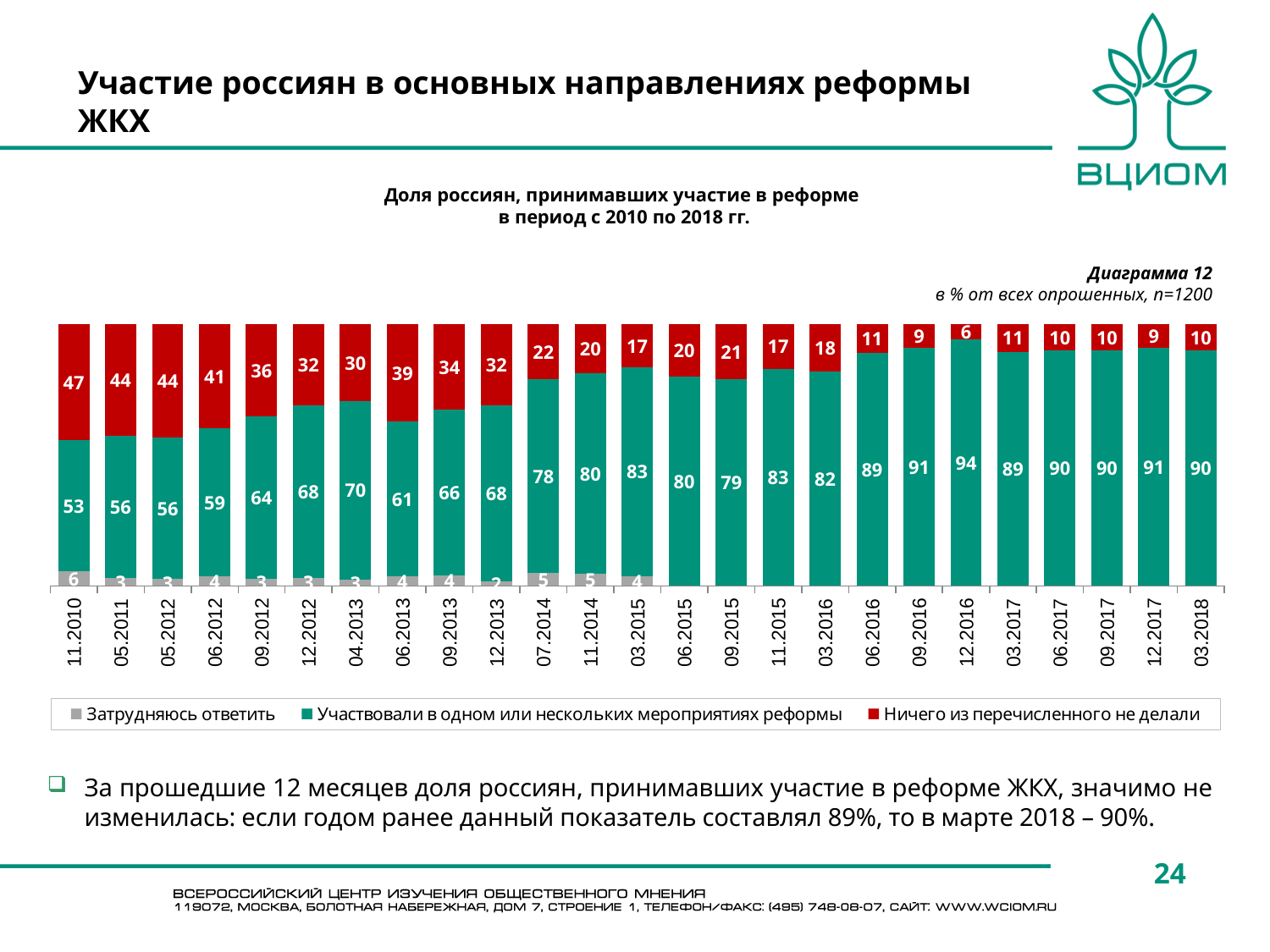
In which period is the value for 'Ничего из перечисленного не делали' lowest? 12.2016 Which is larger: the 'Ничего из перечисленного не делали' value in 06.2013 or in 12.2013? 06.2013 What is the total of the stacked bar for 03.2018? 100 What is the value for 'Участвовали в одном или нескольких мероприятиях реформы' in 03.2018? 90 What type of chart is shown on the slide? Stacked bar chart In which period is the value for 'Участвовали в одном или нескольких мероприятиях реформы' highest? 12.2016 Does the value for 'Участвовали в одном или нескольких мероприятиях реформы' generally rise or fall from 11.2010 to 03.2018? Rise What is the difference between the 'Участвовали в одном или нескольких мероприятиях реформы' values in 03.2018 and 11.2010? 37 How many time points (categories) are shown on the x axis? 25 What is the value for 'Затрудняюсь ответить' in 11.2010? 6 How many series does the legend list? 3 What is the value for 'Ничего из перечисленного не делали' in 11.2010? 47